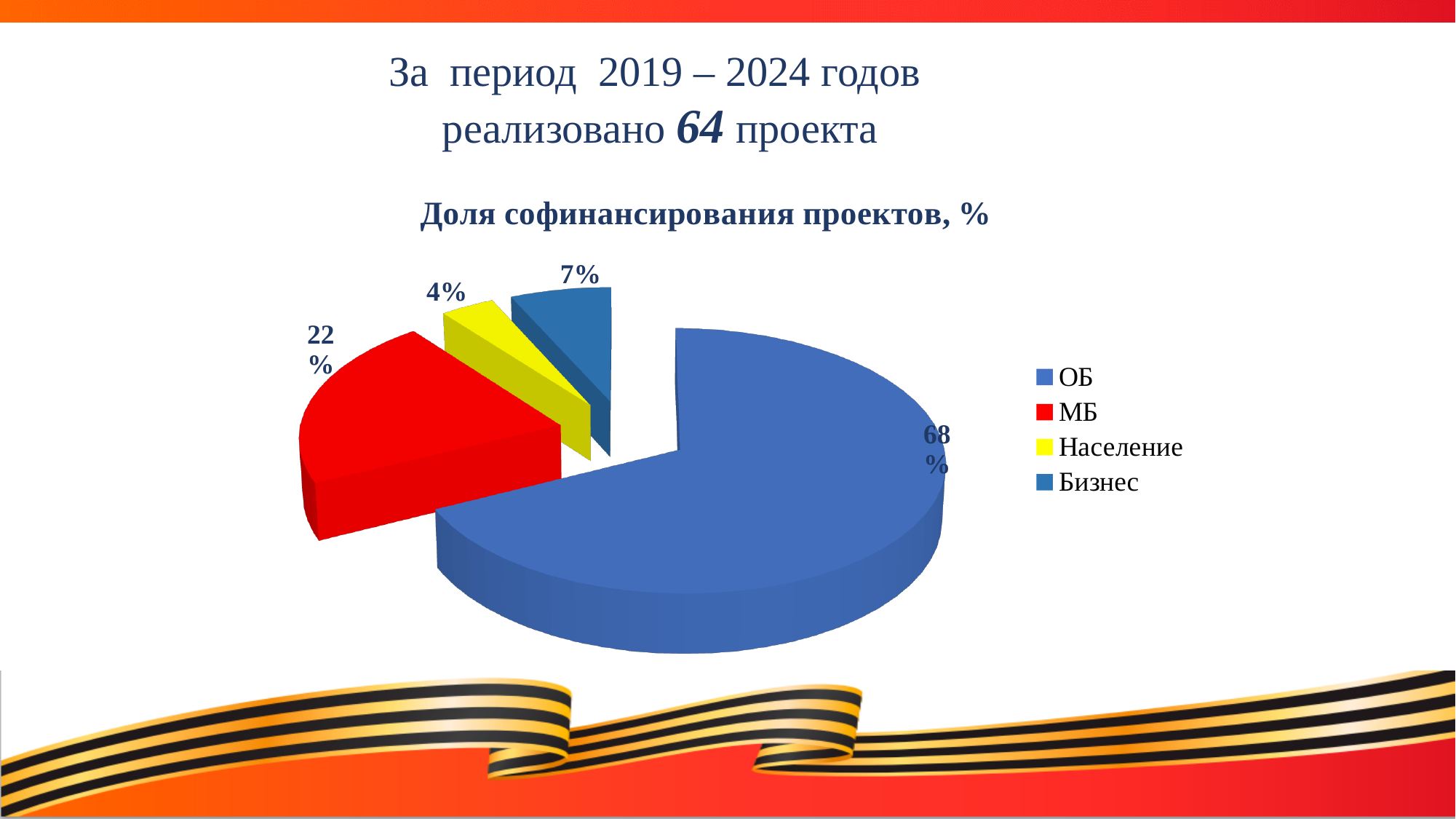
What share of the pie does ОБ account for? 68% What share of the pie does МБ account for? 22% What is the difference between the shares of ОБ and МБ? 46% Which category has the largest share of the pie? ОБ How many slices does the pie chart have? 4 Which is larger, the share of Бизнес or the share of Население? Бизнес What colour is the slice for МБ? Red What share of the pie does Население account for? 4% What share of the pie does Бизнес account for? 7% Which category has the smallest share of the pie? Население What kind of chart is shown on the slide? Pie chart What is the title of the chart? Доля софинансирования проектов, %